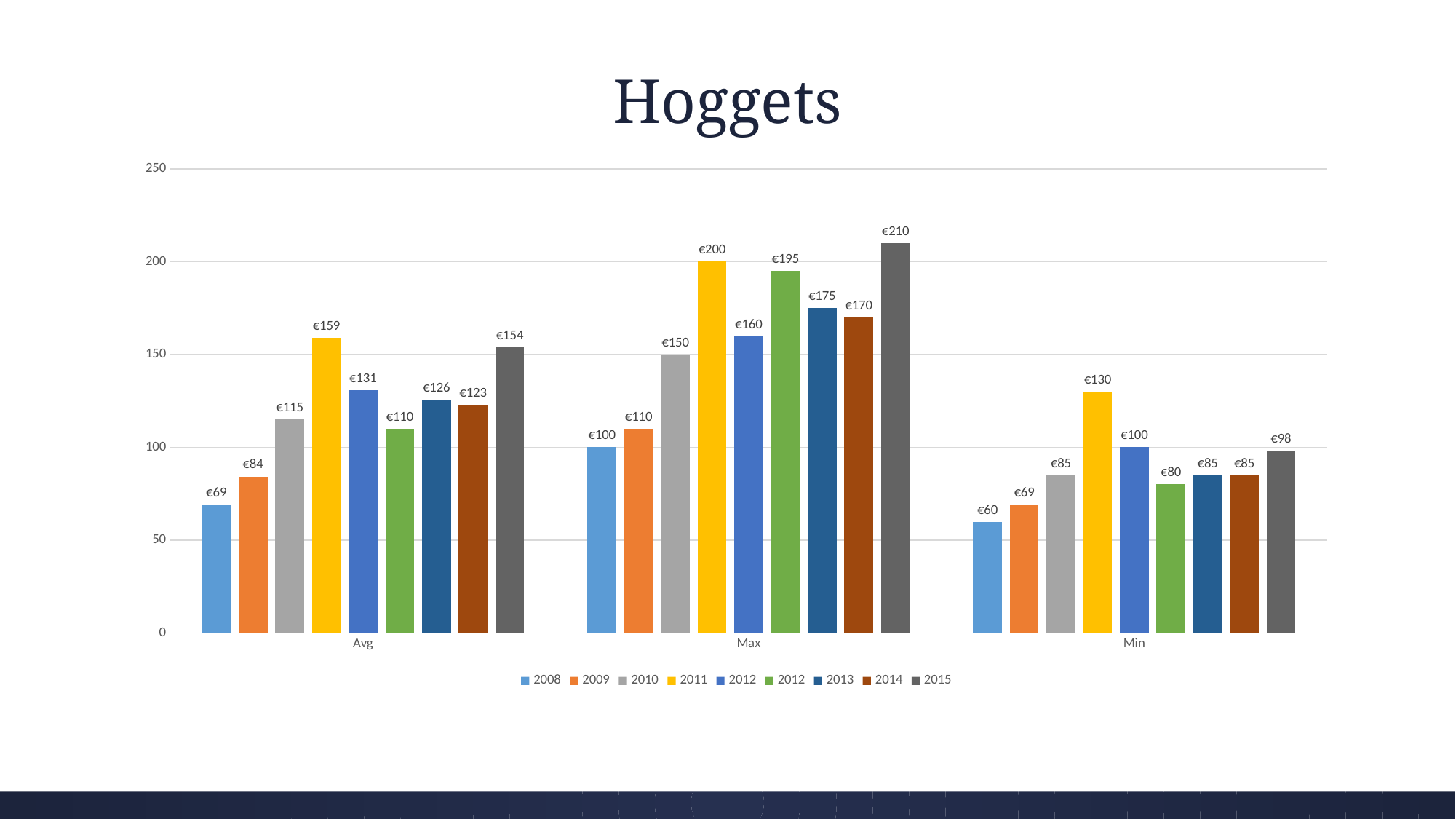
Which year has the lowest value in the Avg category? 2008 What is the value for 2014 in the Max category? €170 What is the value for 2011 in the Avg category? €159 What is the value for 2015 in the Max category? €210 In the Min category, which is larger: the value for 2011 or the value for 2015? 2011 Which year has the highest value in the Min category? 2011 What kind of chart is shown on the slide? Bar chart What is the value for 2008 in the Min category? €60 What is the difference between the 2015 and 2008 values in the Max category? €110 Which year has the highest value in the Max category? 2015 How many series does the legend list? 9 How many categories are shown on the x axis? 3